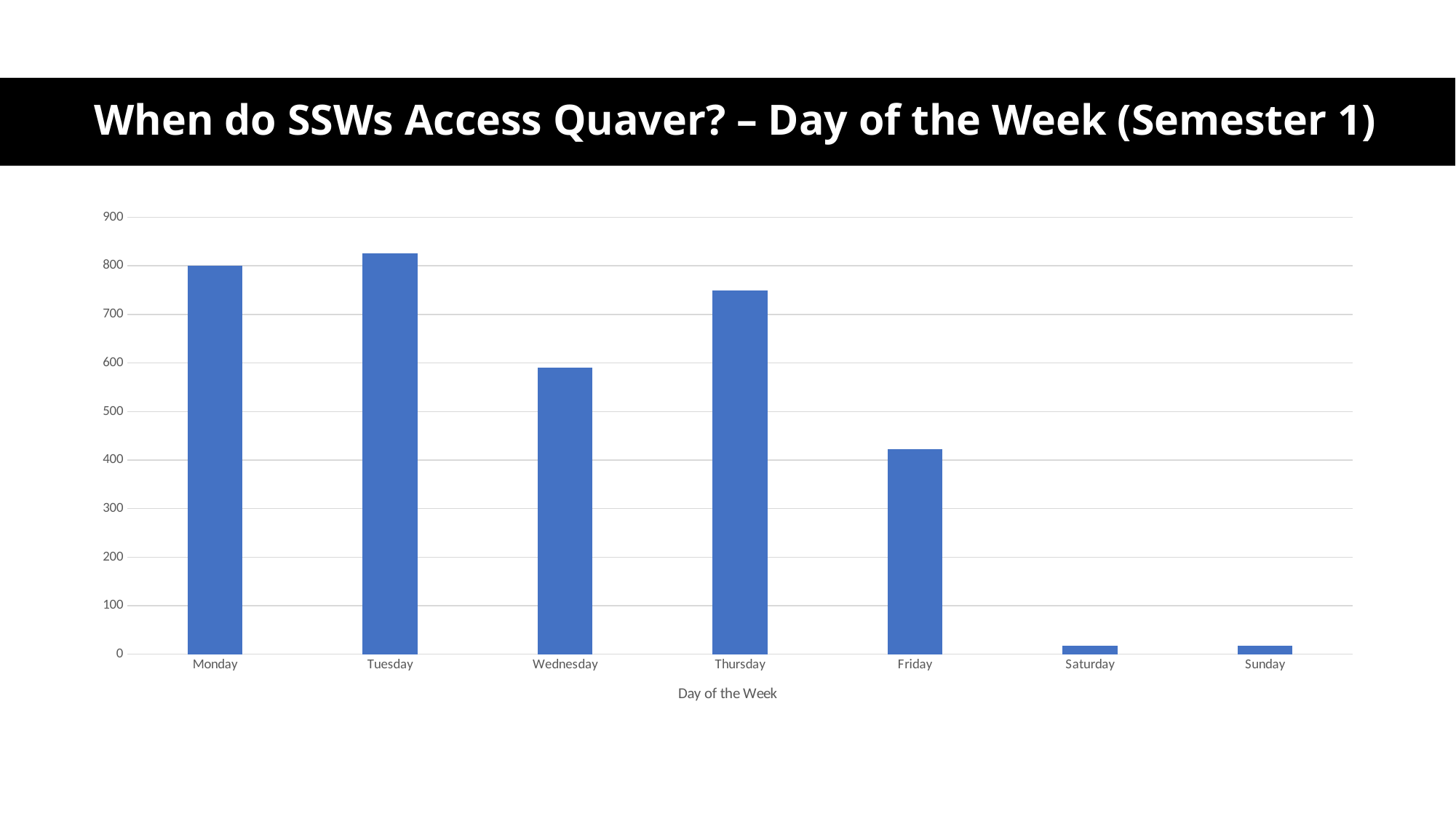
Is the value for Friday greater or less than 400? greater Which day of the week has the highest value? Tuesday How many days of the week are plotted on the chart? 7 Is the value for Tuesday greater or less than 800? greater Do the values rise or fall from Thursday to Sunday? fall What kind of chart is shown on the slide? bar chart Which is larger, the value for Thursday or the value for Friday? Thursday Which is larger, the value for Monday or the value for Wednesday? Monday Is the value for Thursday greater or less than 700? greater What is the label on the x axis of the chart? Day of the Week